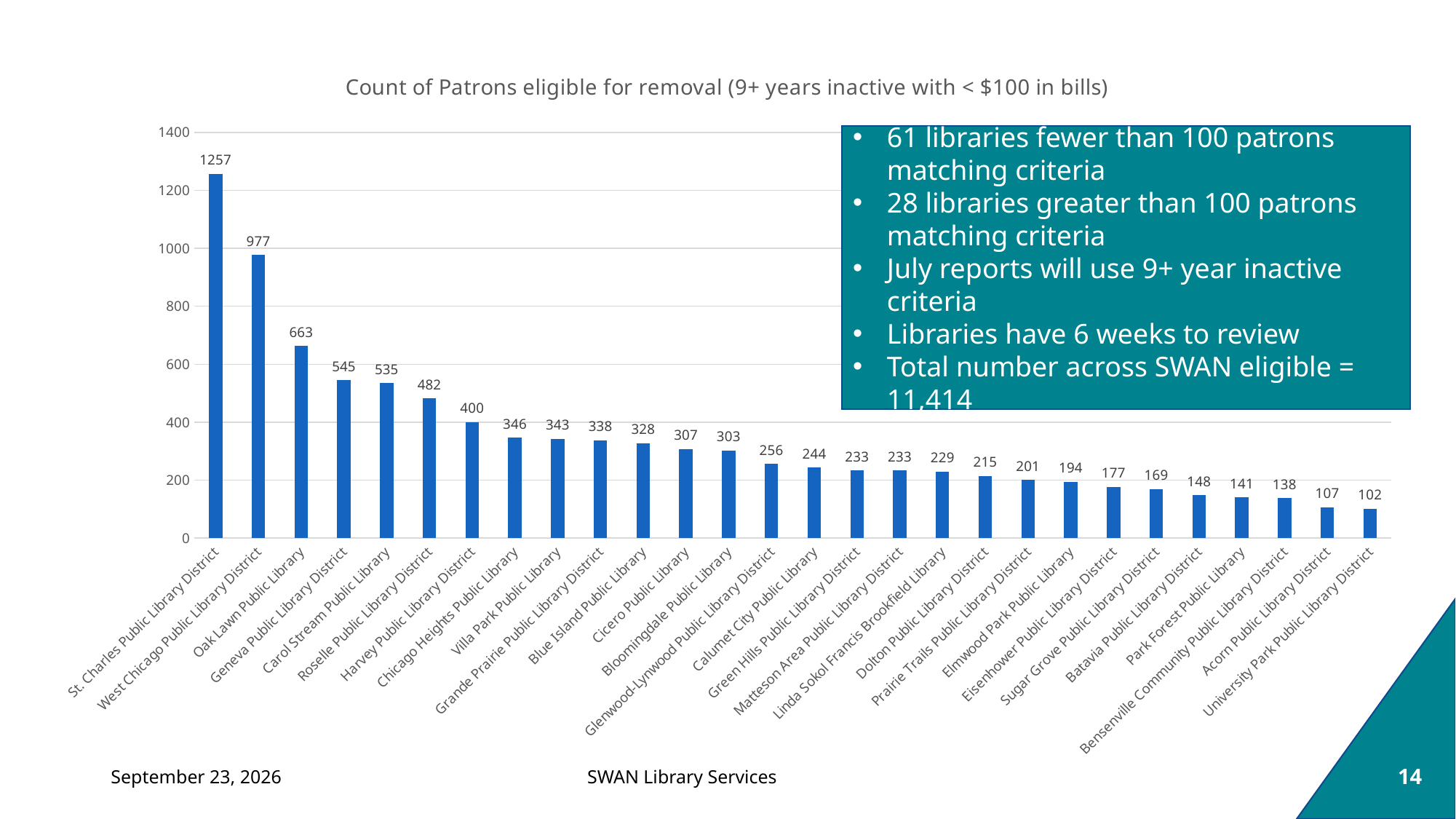
What kind of chart is shown on the slide? Bar chart What is the title of the chart? Count of Patrons eligible for removal (9+ years inactive with < $100 in bills) What is the value shown for Cicero Public Library? 307 What is the count of patrons eligible for removal for St. Charles Public Library District? 1257 Is the value for Dolton Public Library District greater or less than 400? less How many libraries are shown in the chart? 28 Which library has the lowest count of patrons eligible for removal? University Park Public Library District What is the difference between the values for Oak Lawn Public Library and Geneva Public Library District? 118 What is the difference between the values for St. Charles Public Library District and West Chicago Public Library District? 280 Which has a larger value, Roselle Public Library District or Harvey Public Library District? Roselle Public Library District Which library has the highest count of patrons eligible for removal? St. Charles Public Library District What is the value shown for Harvey Public Library District? 400